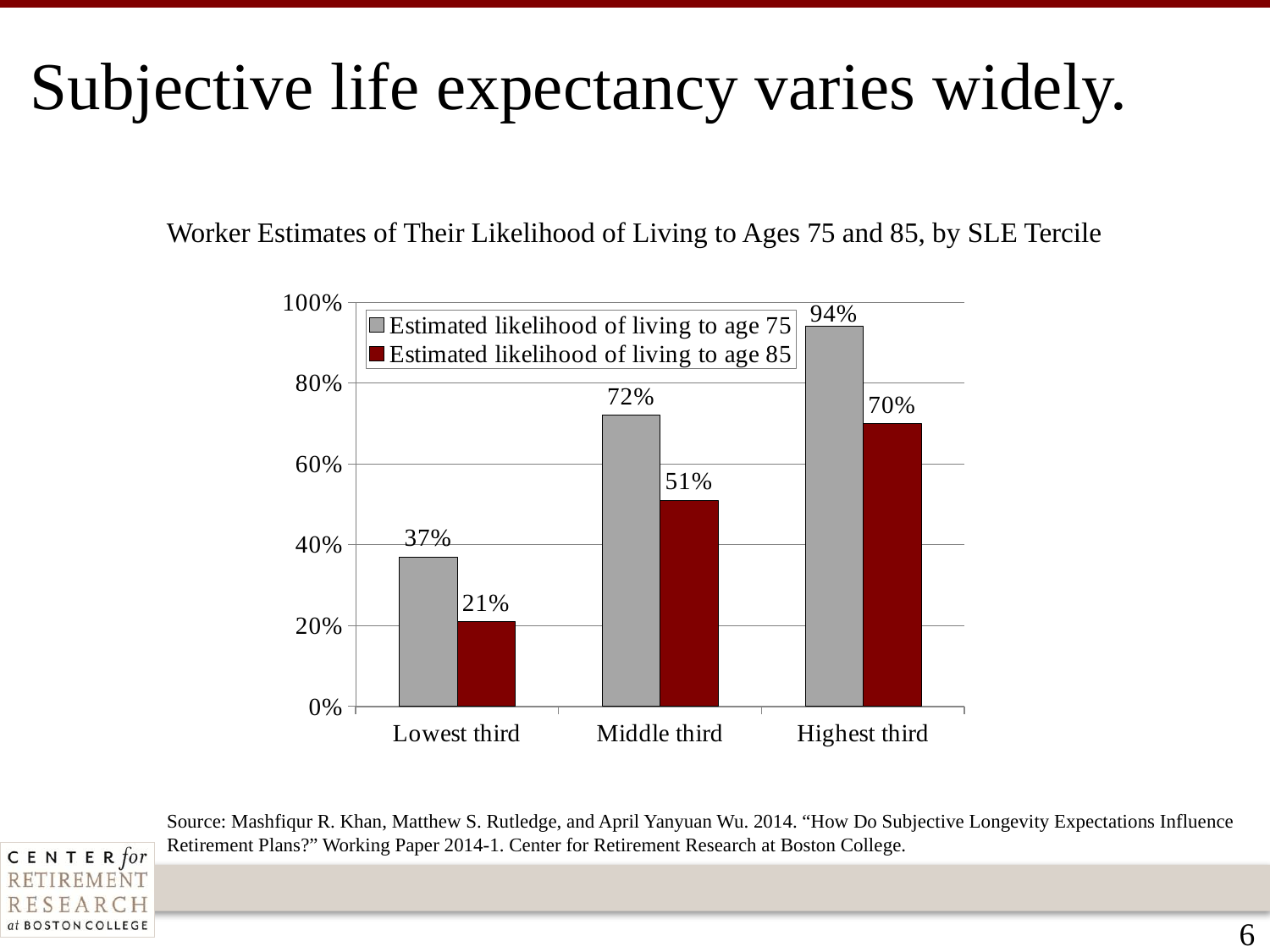
What is the estimated likelihood of living to age 75 for the Lowest third tercile? 37% What is the difference between the estimated likelihood of living to age 75 for the Middle third and the Lowest third? 35% Do the estimated likelihoods of living to age 85 rise or fall from the Lowest third to the Highest third? Rise How many series does the legend list? 2 What kind of chart is shown on the slide? Bar chart Which is larger: the estimated likelihood of living to age 85 for the Highest third or the estimated likelihood of living to age 75 for the Middle third? Estimated likelihood of living to age 75 for the Middle third What is the estimated likelihood of living to age 85 for the Middle third tercile? 51% How many terciles are shown on the x axis? 3 Which tercile has the highest estimated likelihood of living to age 75? Highest third What is the difference between the estimated likelihood of living to age 75 and to age 85 for the Highest third tercile? 24% Which tercile has the lowest estimated likelihood of living to age 85? Lowest third What is the estimated likelihood of living to age 85 for the Highest third tercile? 70%